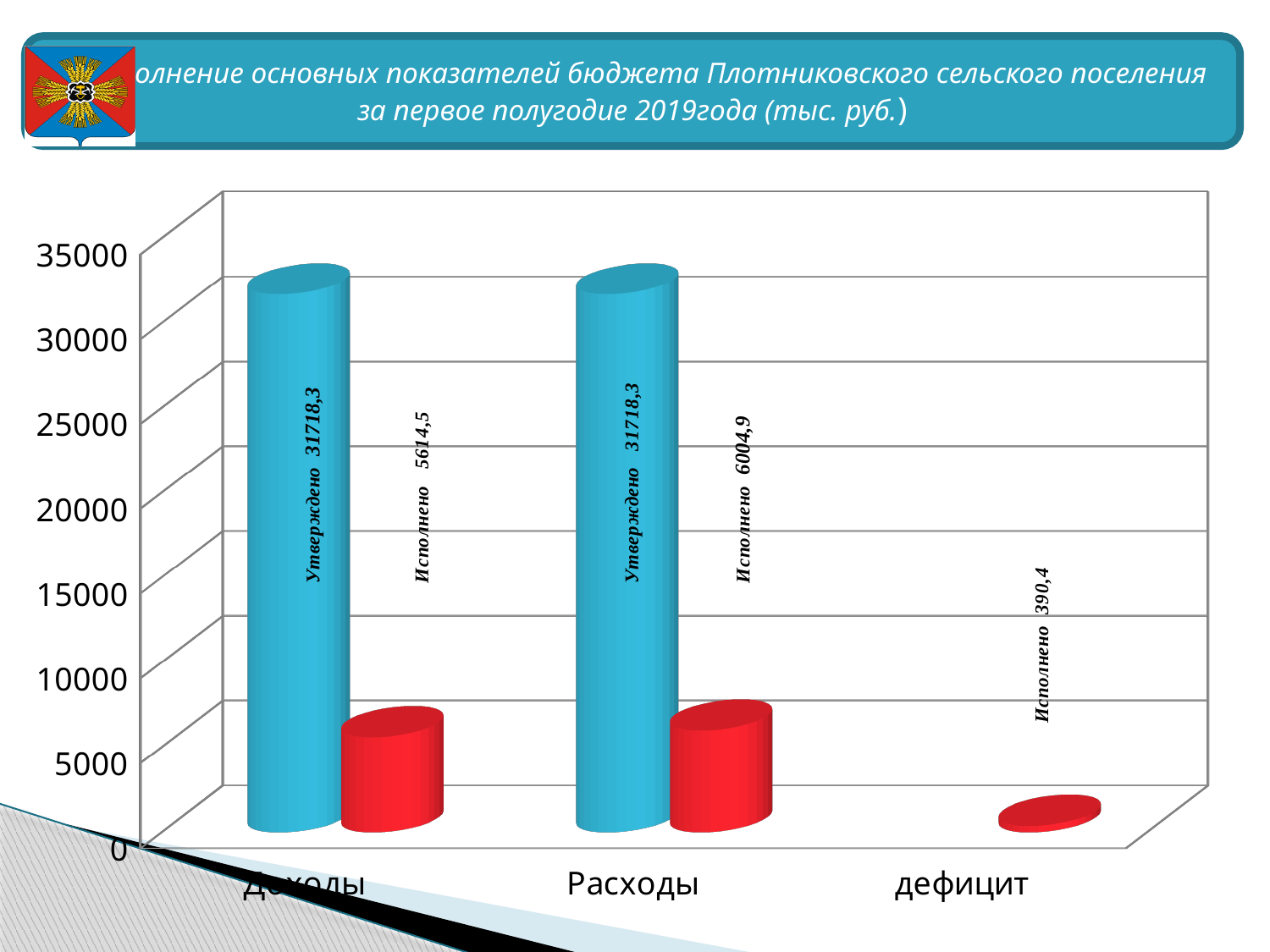
What is the difference between the executed values for Расходы and Доходы? 390,4 Is the approved (Утверждено) value for Расходы greater or less than 30000? greater What is the approved (Утверждено) value for Доходы? 31718,3 What is the difference between the approved and executed values for Доходы? 26103,8 What is the executed (Исполнено) value for дефицит? 390,4 How many categories are shown on the x axis? 3 What is the executed (Исполнено) value for Доходы? 5614,5 What is the executed (Исполнено) value for Расходы? 6004,9 What is the approved (Утверждено) value for Расходы? 31718,3 What kind of chart is shown on the slide? Bar chart Which category has the lowest executed (Исполнено) value? дефицит Which is larger, the executed value for Расходы or the executed value for Доходы? Расходы